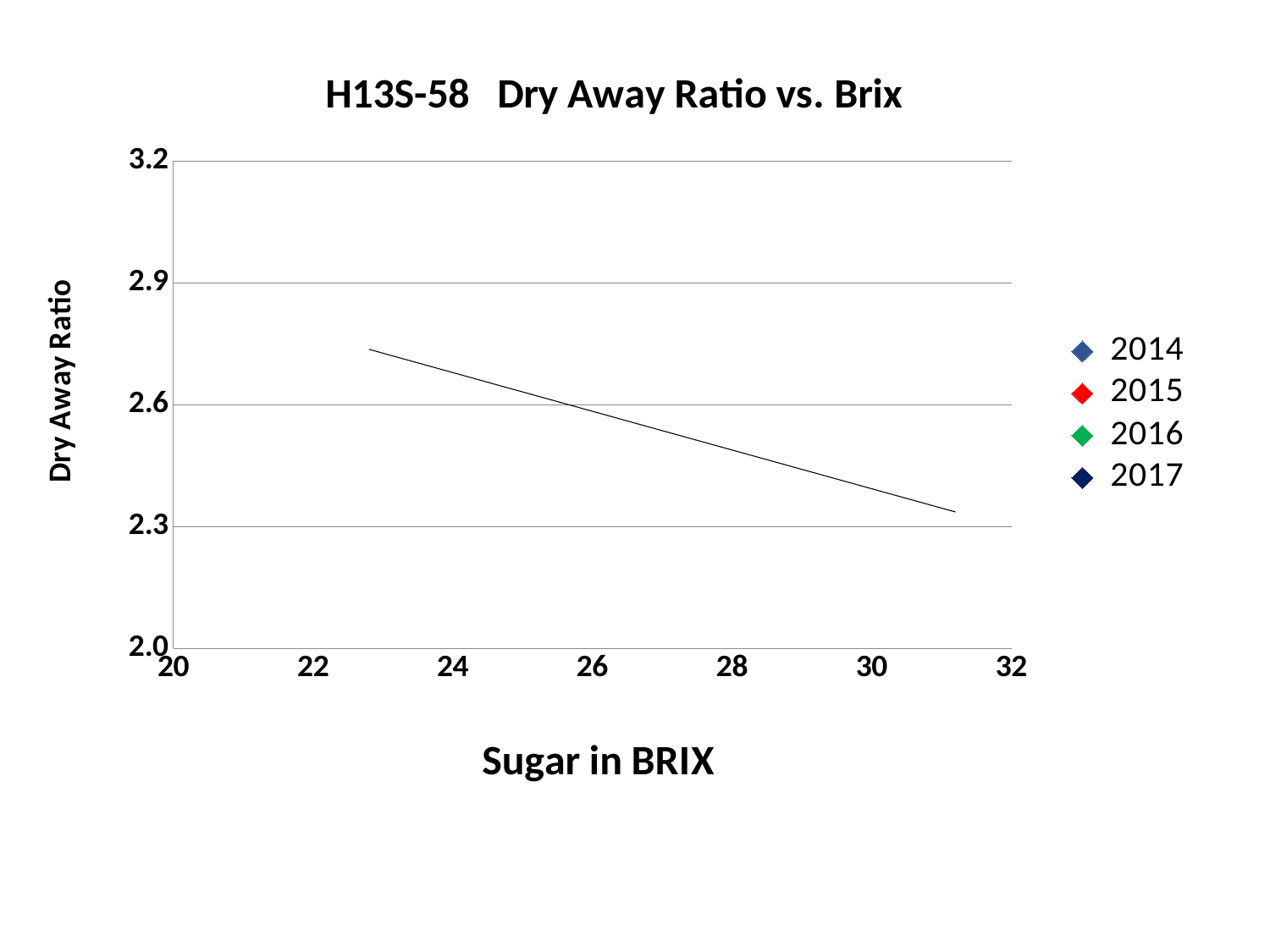
What kind of chart is shown on the slide? scatter chart What is the label of the x axis? Sugar in BRIX What is the title of the chart? H13S-58 Dry Away Ratio vs. Brix Is the trend line value at a Brix of 28 greater or less than 2.6? less Is the trend line value at a Brix of 30 greater or less than 2.6? less Is the trend line value at a Brix of 31 greater or less than 2.3? greater How many series does the legend list? 4 Does the trend line rise or fall as Sugar in BRIX increases? fall